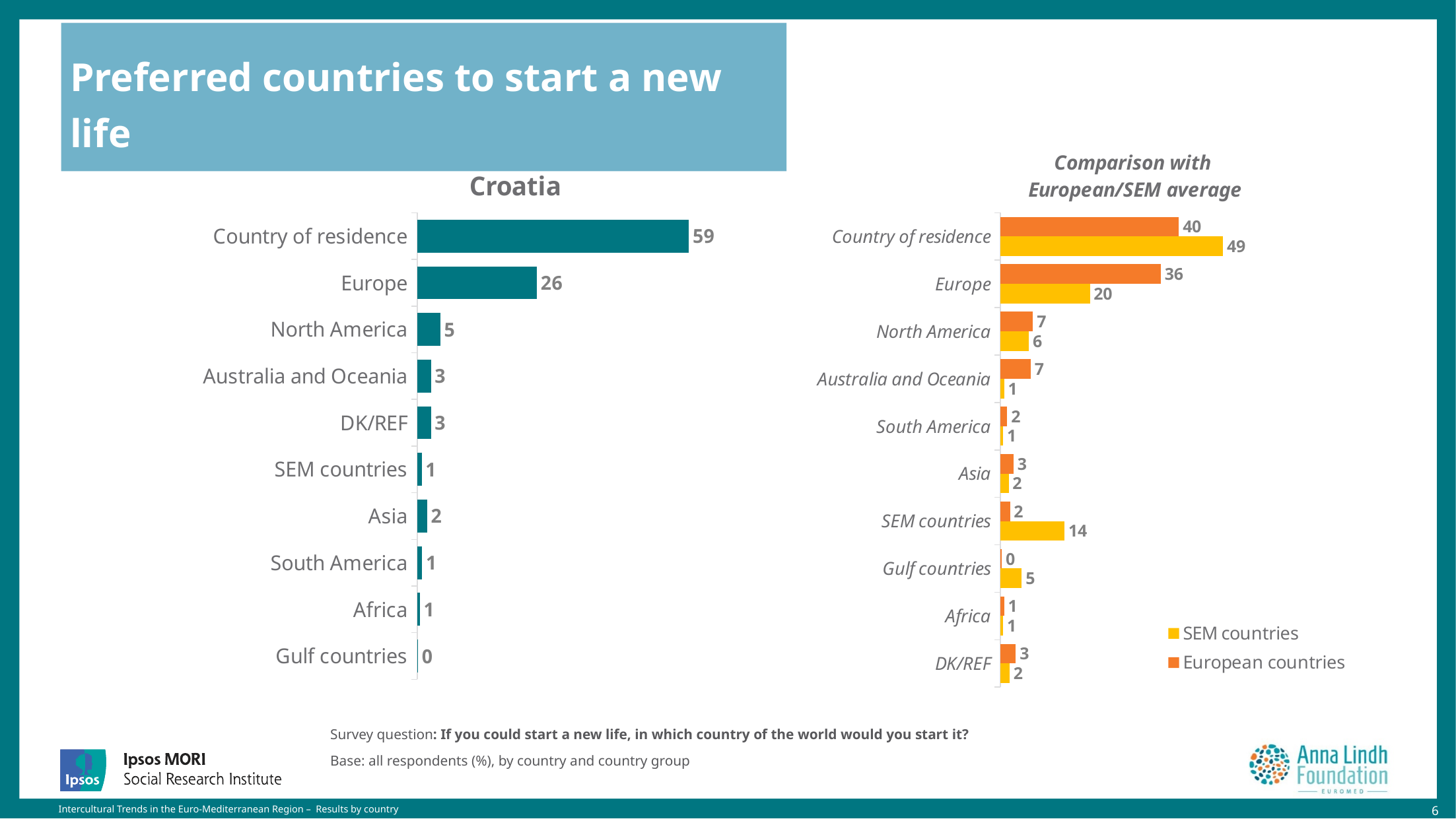
What kind of chart is the Croatia chart? Bar chart In the Croatia chart, how many categories are shown? 10 In the Comparison with European/SEM average chart, how many series does the legend list? 2 In the Comparison with European/SEM average chart, which is larger for SEM countries: the SEM countries value or the European countries value? SEM countries In the Comparison with European/SEM average chart, what is the SEM countries value for Country of residence? 49 In the Croatia chart, which category has the highest value? Country of residence In the Croatia chart, what is the difference between Country of residence and Europe? 33 In the Comparison with European/SEM average chart, which colour represents SEM countries? Yellow In the Comparison with European/SEM average chart, what is the European countries value for Europe? 36 In the Croatia chart, what is the value for Europe? 26 In the Comparison with European/SEM average chart, what is the difference between the European countries and SEM countries values for Europe? 16 In the Croatia chart, what is the value for Gulf countries? 0